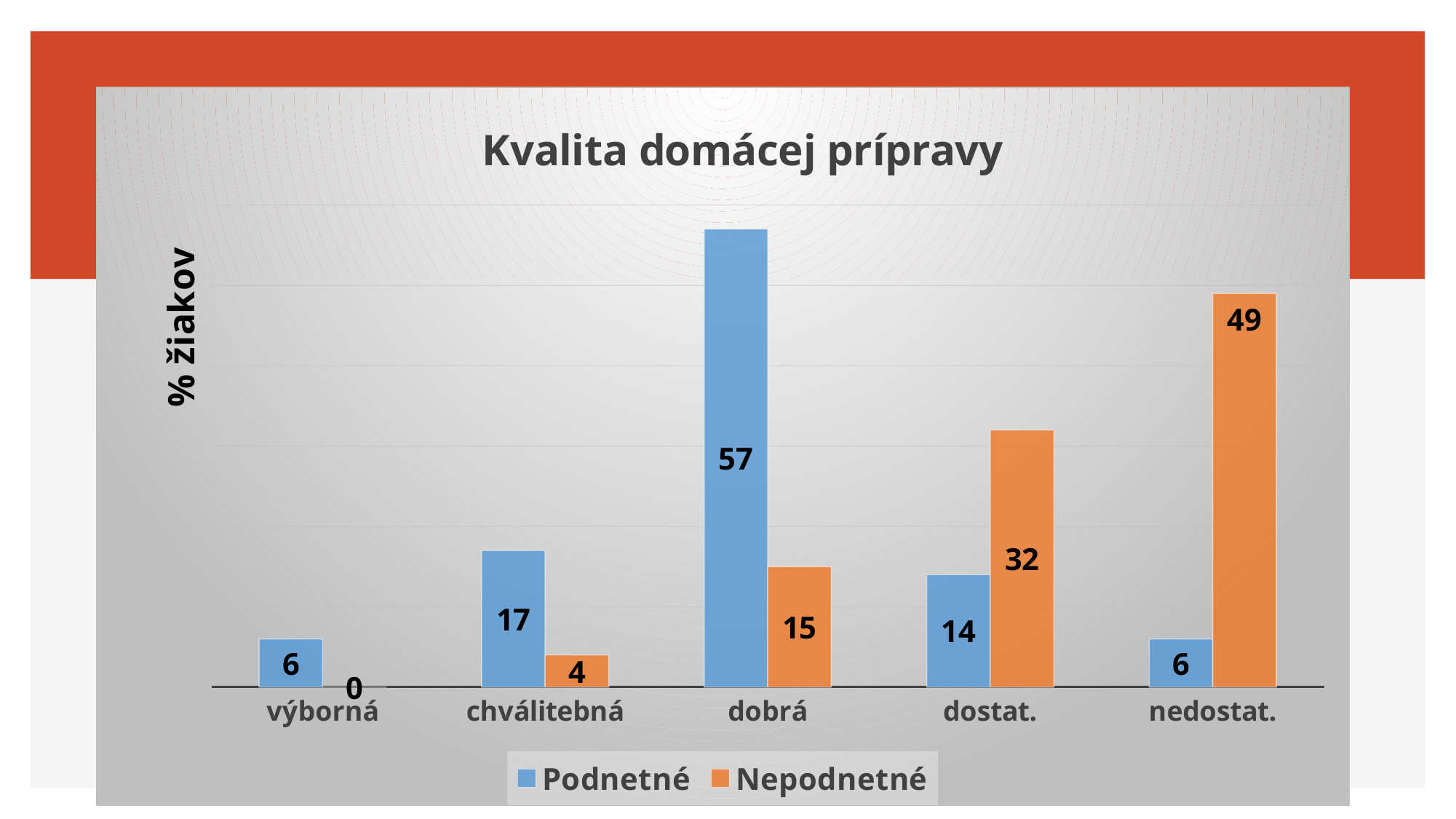
What kind of chart is shown? bar chart What is the difference between the Nepodnetné and Podnetné values in the nedostat. category? 43 How many categories are shown on the x axis? 5 What is the value for Nepodnetné in the nedostat. category? 49 How many series does the legend list? 2 What is the value for Podnetné in the dobrá category? 57 What is the title of the chart? Kvalita domácej prípravy What is the label on the vertical axis? % žiakov Which is larger in the dostat. category, Podnetné or Nepodnetné? Nepodnetné Which category has the highest Podnetné value? dobrá Which category has the lowest Nepodnetné value? výborná What is the value for Nepodnetné in the výborná category? 0